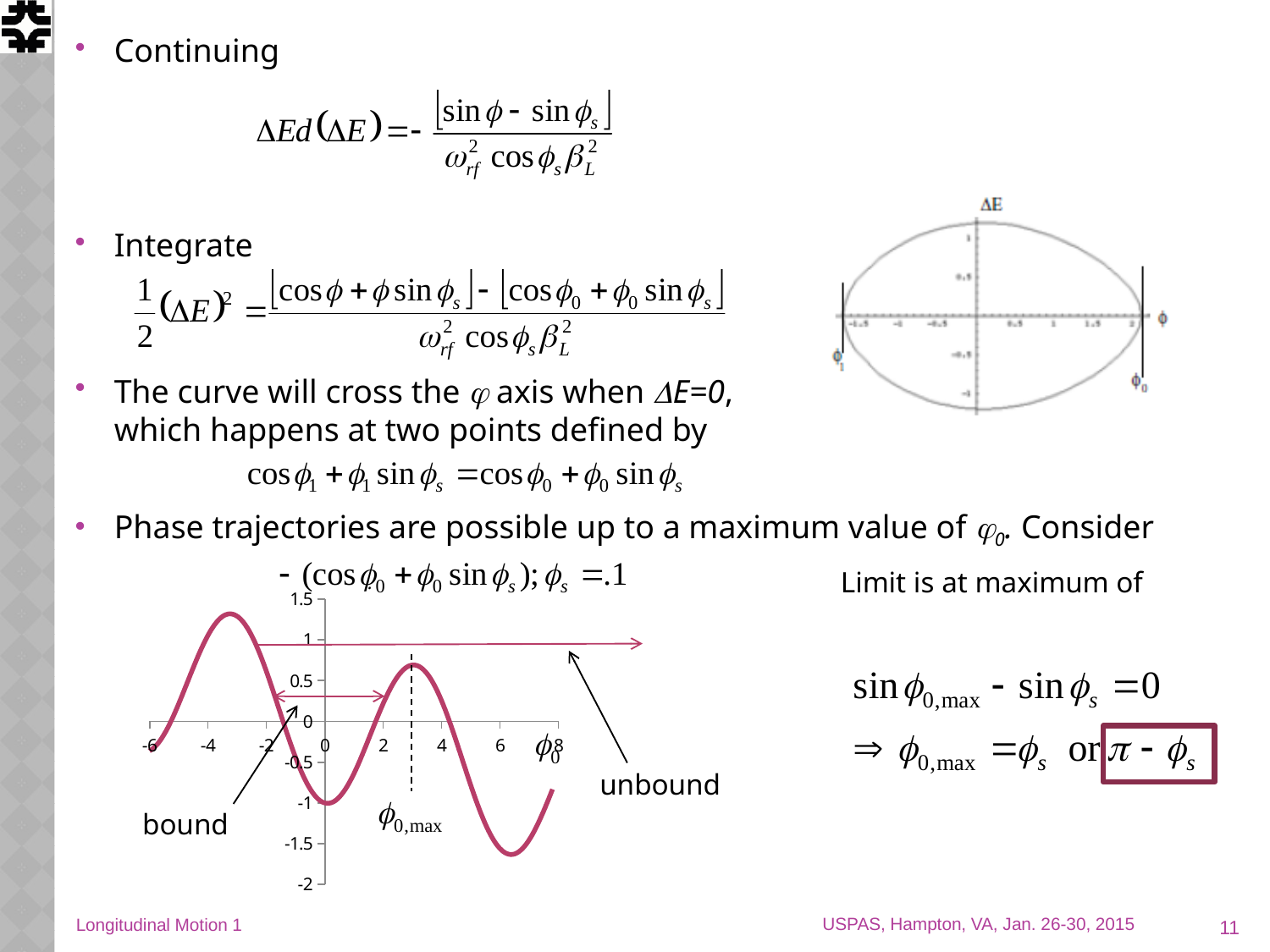
On the bottom-left chart, what is the highest value shown on the x axis? 8 On the bottom-left chart, is the minimum of the curve near φ0 = 6 greater or less than -1? less How many curves are plotted on the bottom-left chart? 1 On the bottom-left chart, which peak is higher: the one near φ0 = -3 or the one near φ0 = 3? the one near φ0 = -3 What kind of chart is the bottom-left chart with the x axis labelled φ0? line chart What is the label on the vertical axis of the top-right chart? ΔE On the bottom-left chart, does the curve rise or fall as φ0 goes from 0 to 3? rise On the bottom-left chart, is the peak of the curve near φ0 = 3 greater or less than 1? less On the bottom-left chart, is the peak of the curve near φ0 = -3 greater or less than 1? greater On the bottom-left chart, what is the lowest value shown on the y axis? -2 What kind of chart is the top-right chart showing ΔE against φ? line chart